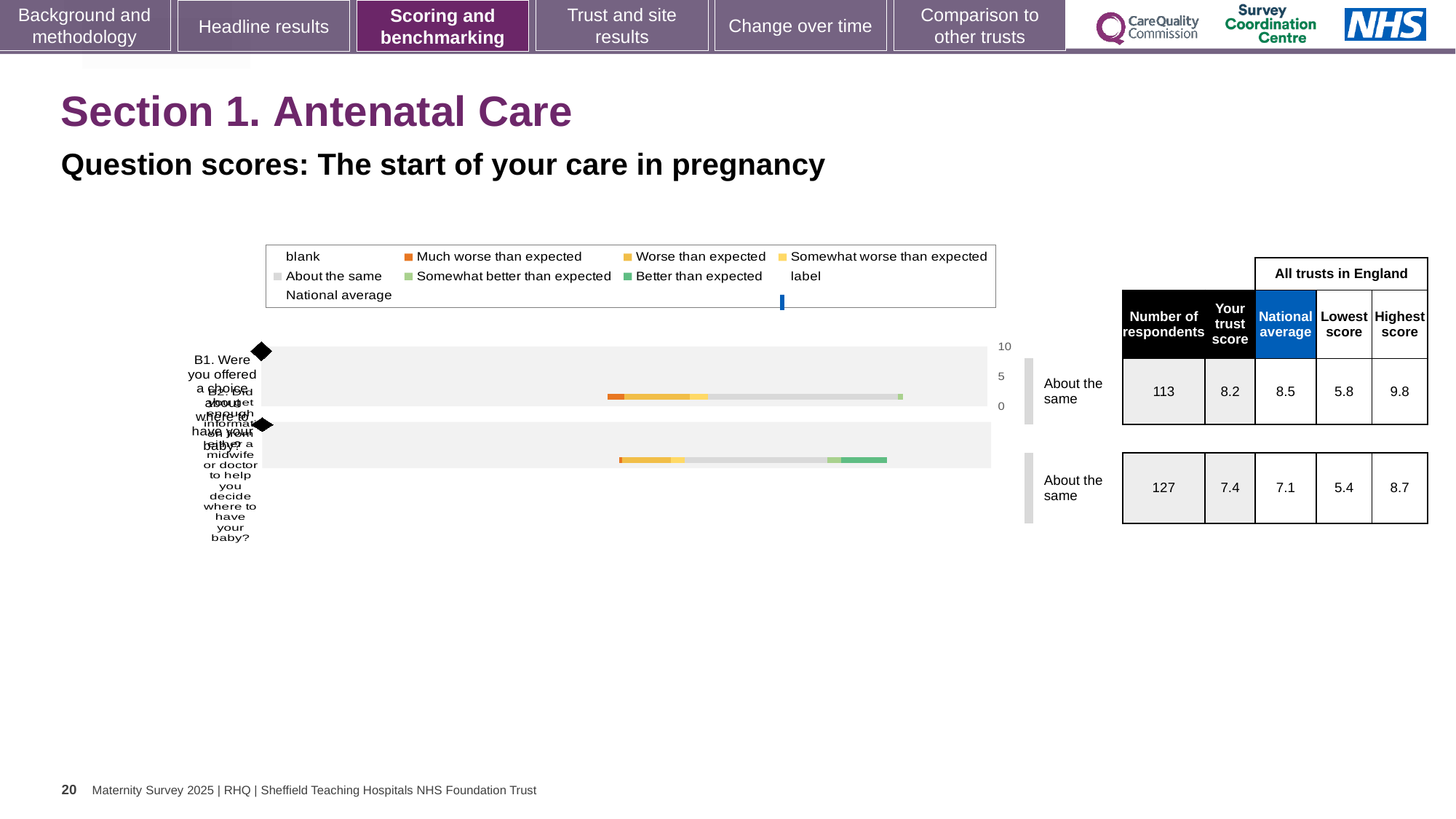
What kind of chart is shown on the slide? bar chart In the table beside the chart, what is 'Your trust score' for B1? 8.2 Which colour does the legend use for 'Much worse than expected'? orange In the table beside the chart, which question has the higher trust score, B1 or B2? B1 In the table beside the chart, what is the number of respondents for B1 (Were you offered a choice about where to have your baby?)? 113 In the table beside the chart, what is the national average for B2 (Did you get enough information to help you decide where to have your baby?)? 7.1 In the table beside the chart, what is the difference between the highest score and the lowest score for B1? 4.0 In the table beside the chart, what is the difference between the trust score and the national average for B2? 0.3 In the table beside the chart, what is the highest score across all trusts in England for B2? 8.7 How many entries does the chart's legend list? 9 How many question categories (bars) does the chart show? 2 Which legend entry is shown in blue? National average